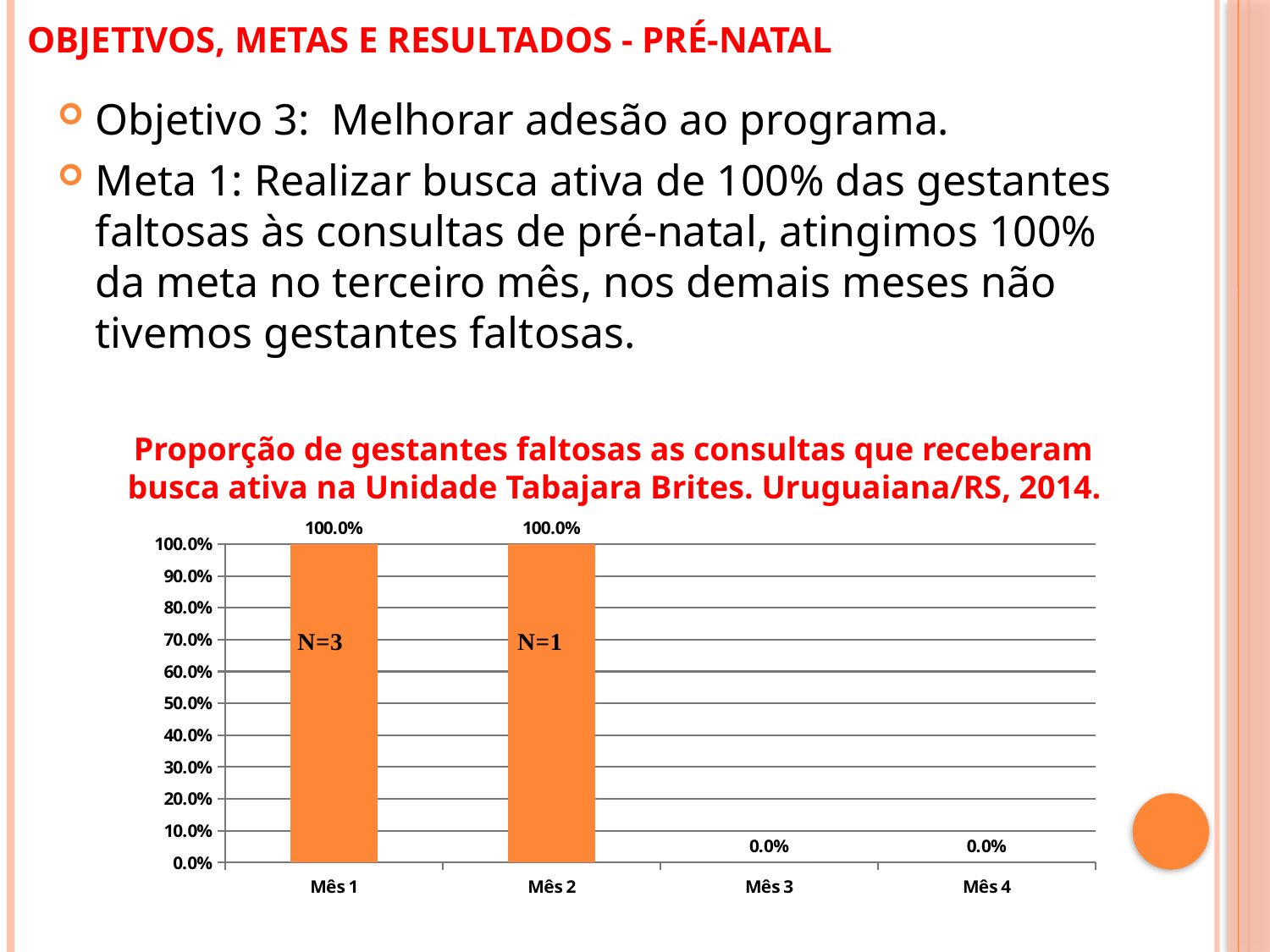
What is the difference between the value for Mês 1 and the value for Mês 4? 100.0% What is the value for Mês 4? 0.0% What is the N value shown on the bar for Mês 1? N=3 What colour are the bars in the chart? Orange What is the value for Mês 1? 100.0% What is the value for Mês 2? 100.0% What is the N value shown on the bar for Mês 2? N=1 What is the value for Mês 3? 0.0% How many categories are shown on the x axis? 4 What kind of chart is shown on the slide? Bar chart Do the values rise or fall from Mês 2 to Mês 3? Fall Which is larger, the value for Mês 2 or the value for Mês 3? Mês 2